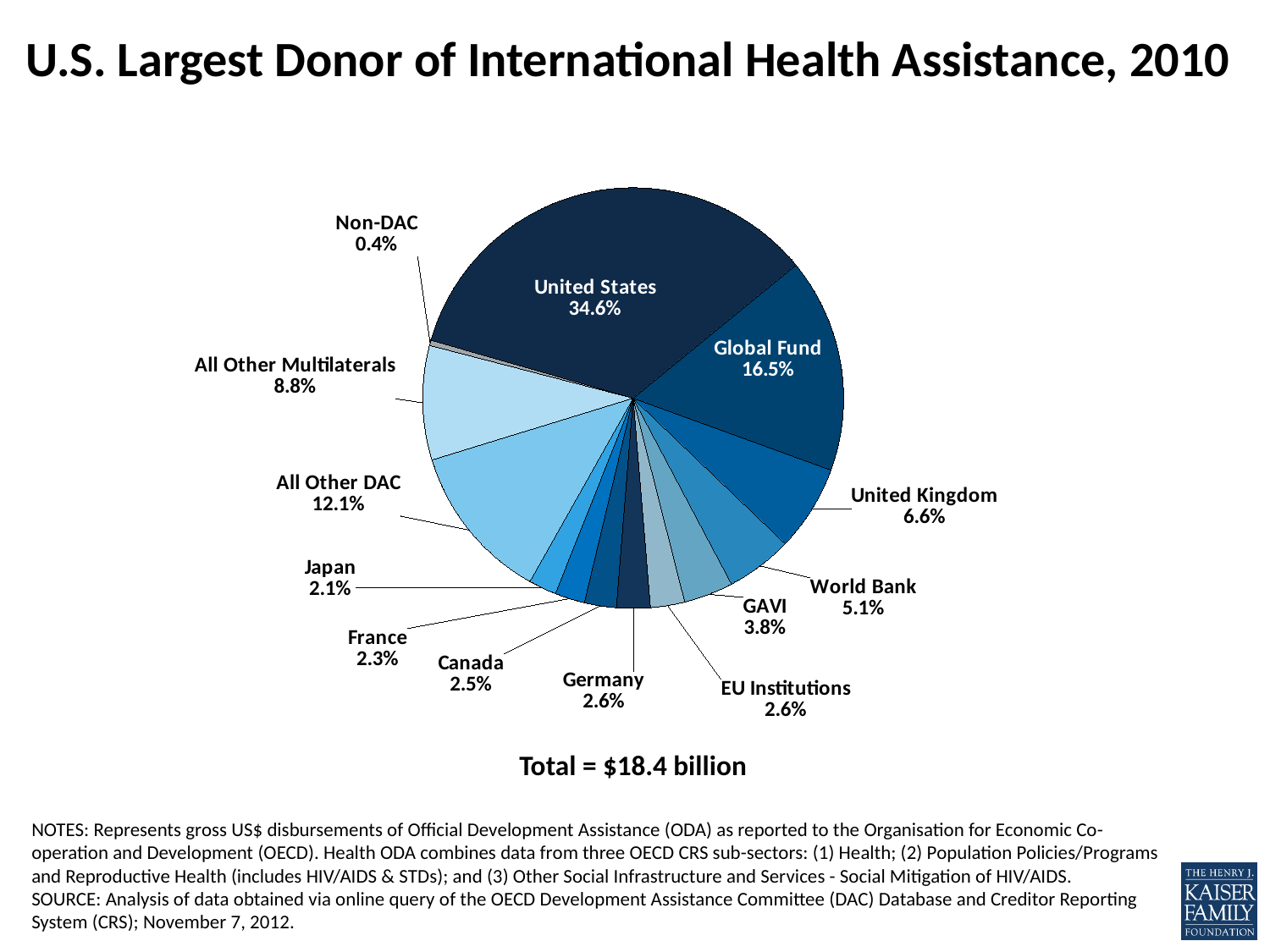
What percentage is shown for the Global Fund slice? 16.5% What is the difference in percentage points between the United States and Global Fund slices? 18.1 Which slice is larger, United Kingdom or World Bank? United Kingdom What share of international health assistance in 2010 does the United States slice represent? 34.6% What percentage is shown for GAVI? 3.8% How many slices does the pie chart have? 13 What percentage is shown for All Other DAC? 12.1% What kind of chart is shown on the slide? Pie chart Which slice of the pie chart is the smallest? Non-DAC What total amount is stated below the pie chart? $18.4 billion Which slice of the pie chart is the largest? United States What is the difference in percentage points between All Other DAC and All Other Multilaterals? 3.3